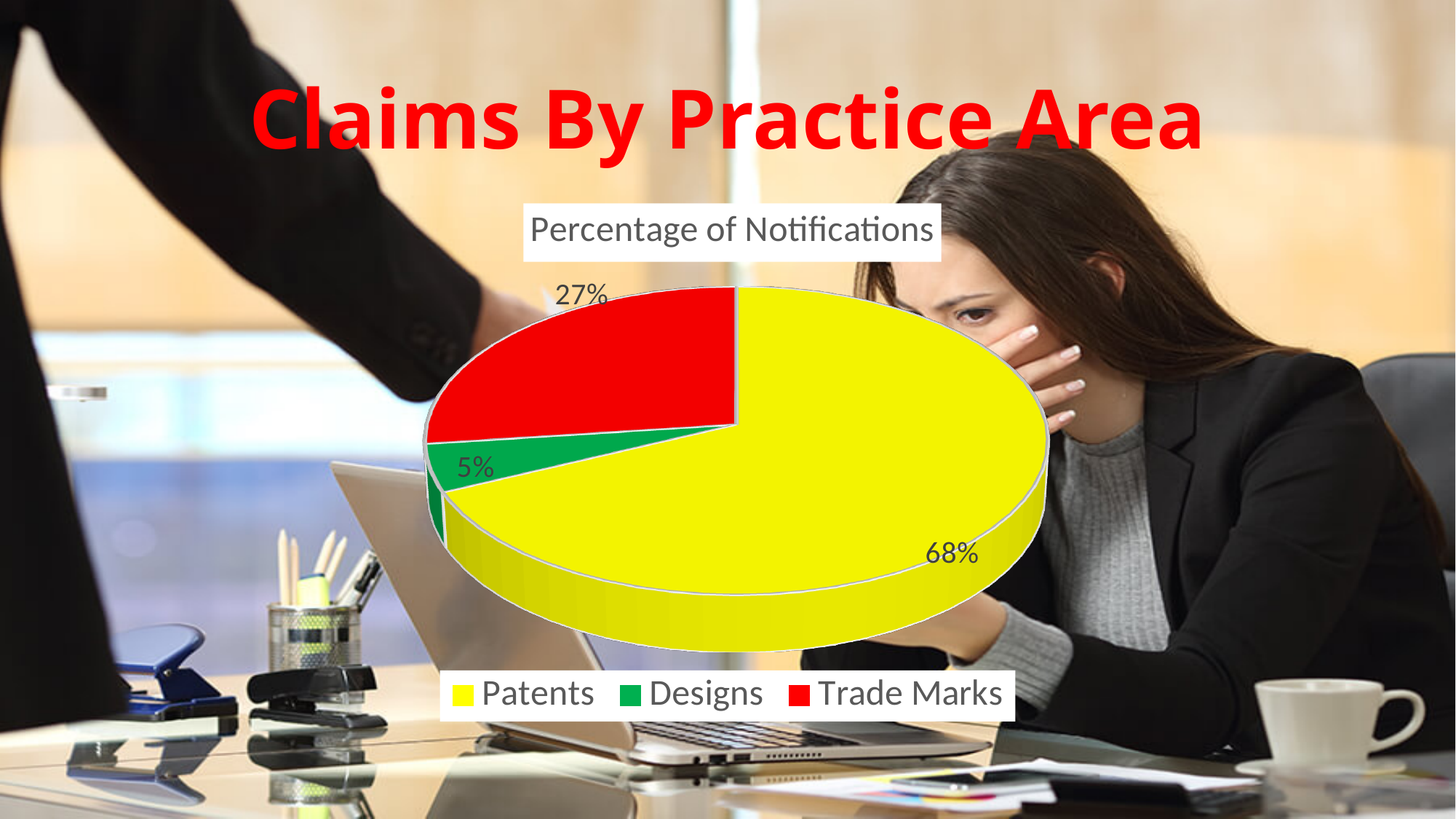
Which practice area has the largest share of notifications? Patents Which has a larger share of notifications, Trade Marks or Designs? Trade Marks How many practice areas are shown in the pie chart? 3 What is the title of the chart? Percentage of Notifications What is the difference in percentage points between Trade Marks and Designs? 22 Which practice area has the smallest share of notifications? Designs What kind of chart is shown on the slide? Pie chart What is the difference in percentage points between Patents and Trade Marks? 41 What percentage of notifications is for Patents? 68% What percentage of notifications is for Trade Marks? 27% Which colour represents Designs in the pie chart? Green What percentage of notifications is for Designs? 5%